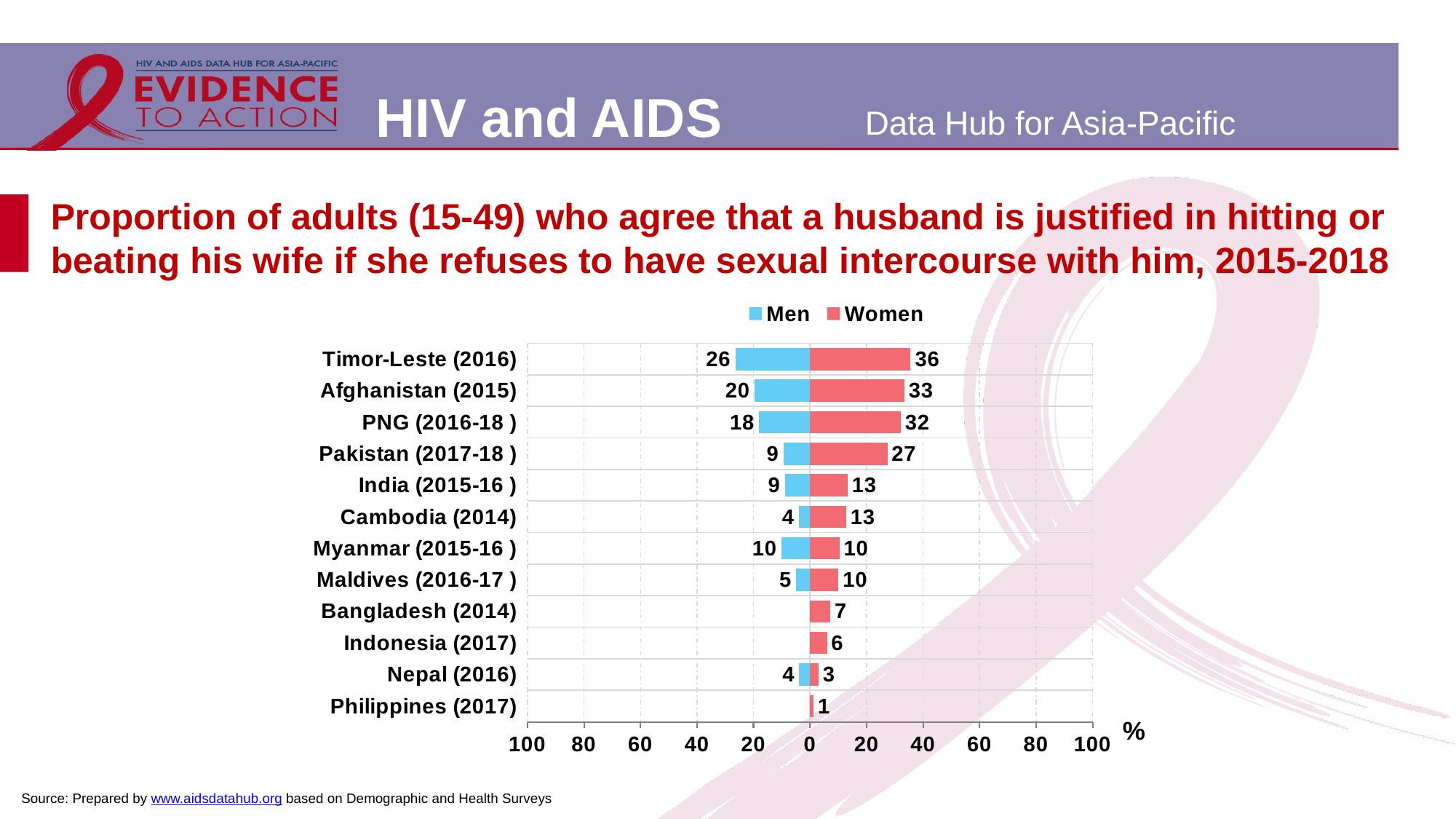
Which country has the lowest value for Women? Philippines (2017) Which is larger for Nepal (2016), the Men value or the Women value? Men What is the value for Women in Pakistan (2017-18)? 27 What is the value for Men in Maldives (2016-17)? 5 What kind of chart is shown on the slide? Bar chart How many countries are shown on the chart? 12 What is the difference between the Women and Men values for PNG (2016-18)? 14 How many series does the legend list? 2 What is the value for Women in Timor-Leste (2016)? 36 Which country has the highest value for Women? Timor-Leste (2016) What is the value for Men in Afghanistan (2015)? 20 Which country has the highest value for Men? Timor-Leste (2016)